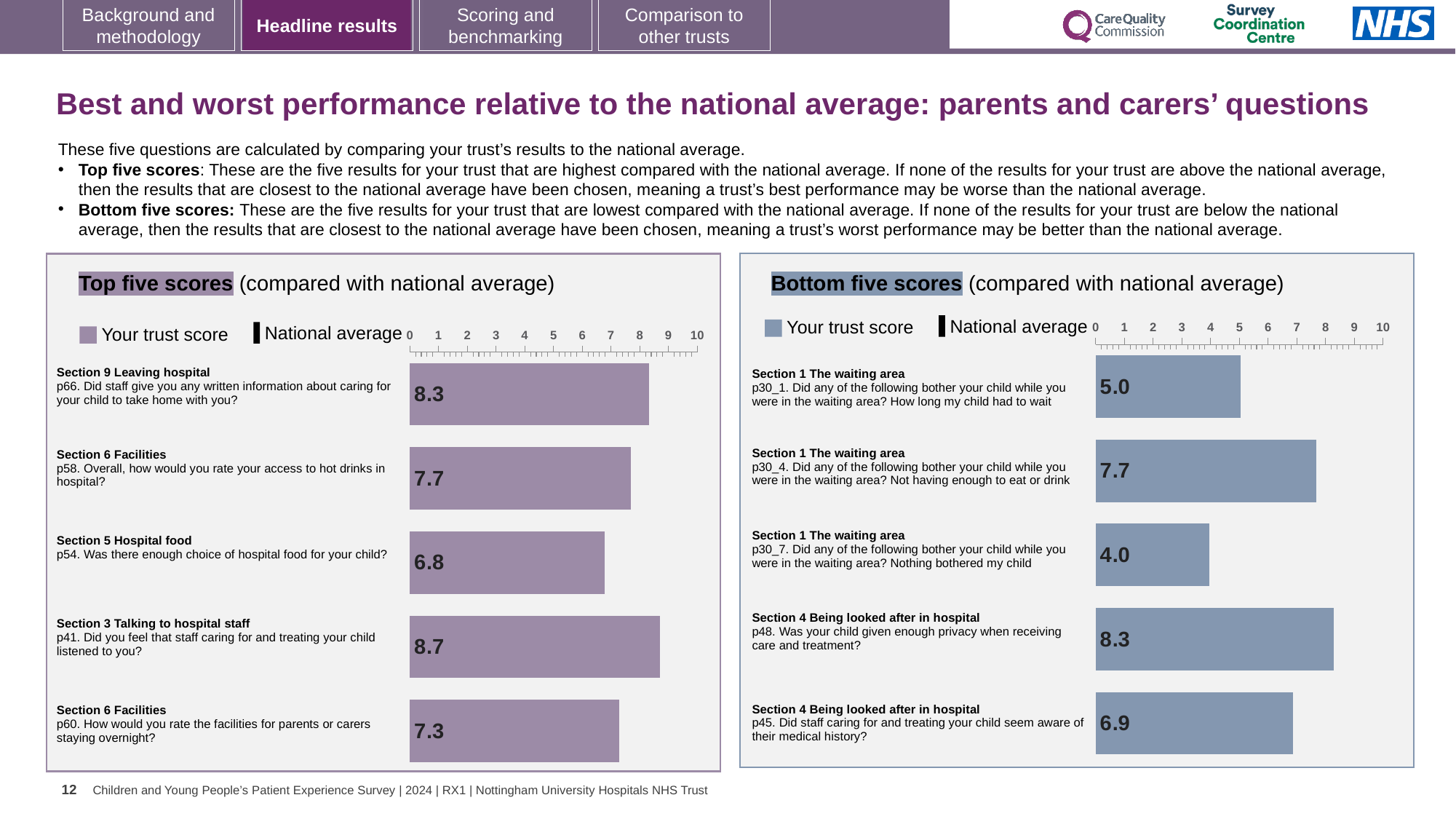
In the Bottom five scores chart, which question has the lowest trust score? p30_7. Did any of the following bother your child while you were in the waiting area? Nothing bothered my child In the Top five scores chart, which question has the lowest trust score? p54. Was there enough choice of hospital food for your child? In the Top five scores chart, what is the trust score for p54 (enough choice of hospital food for your child)? 6.8 In the Bottom five scores chart, what is the trust score for p48 (enough privacy when receiving care and treatment)? 8.3 In the Bottom five scores chart, which is larger: the trust score for p30_1 or for p45? p45 How many questions are plotted in the Bottom five scores chart? 5 In the Top five scores chart, which question has the highest trust score? p41. Did you feel that staff caring for and treating your child listened to you? In the Bottom five scores chart, what is the difference between the trust scores for p48 and p30_7? 4.3 In the Top five scores chart, what is the trust score for p66 (written information about caring for your child to take home)? 8.3 In the Top five scores chart, what is the difference between the trust scores for p41 and p60? 1.4 In the Bottom five scores chart, what is the trust score for p30_7 (Nothing bothered my child)? 4.0 What type of chart is the Top five scores chart? Bar chart